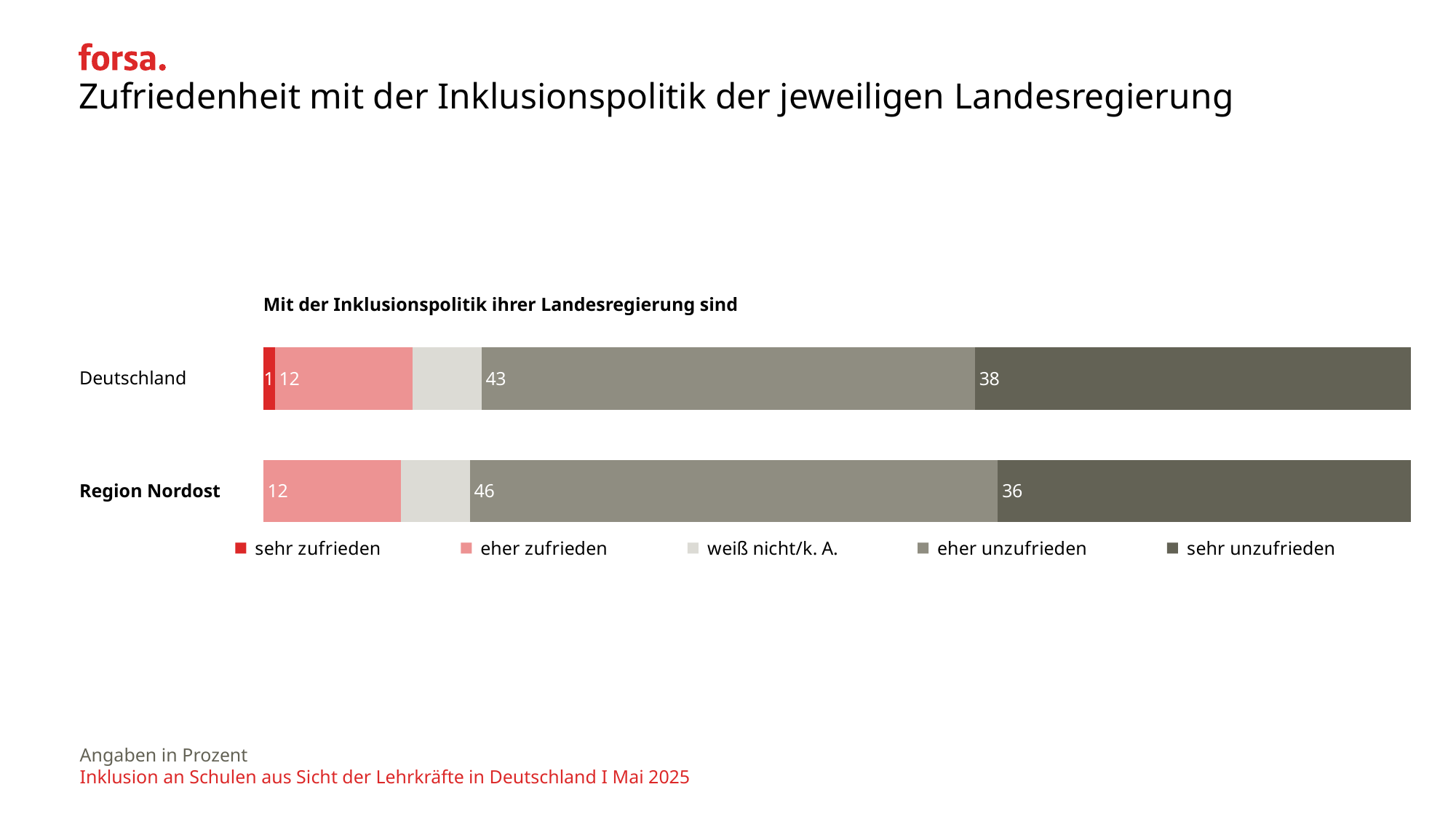
What is the difference between the 'eher unzufrieden' values for Region Nordost and Deutschland? 3 How many categories (rows) does the chart show? 2 What is the value for 'sehr zufrieden' for Deutschland? 1 Which has the larger 'sehr unzufrieden' value, Deutschland or Region Nordost? Deutschland What is the value for 'sehr unzufrieden' for Region Nordost? 36 How many series does the legend list? 5 What is the value for 'sehr unzufrieden' for Deutschland? 38 What is the value for 'eher unzufrieden' for Deutschland? 43 What is the value for 'eher zufrieden' for Region Nordost? 12 Which legend entry is shown in red? sehr zufrieden Which category has the higher 'eher unzufrieden' value? Region Nordost What kind of chart is shown on the slide? stacked bar chart